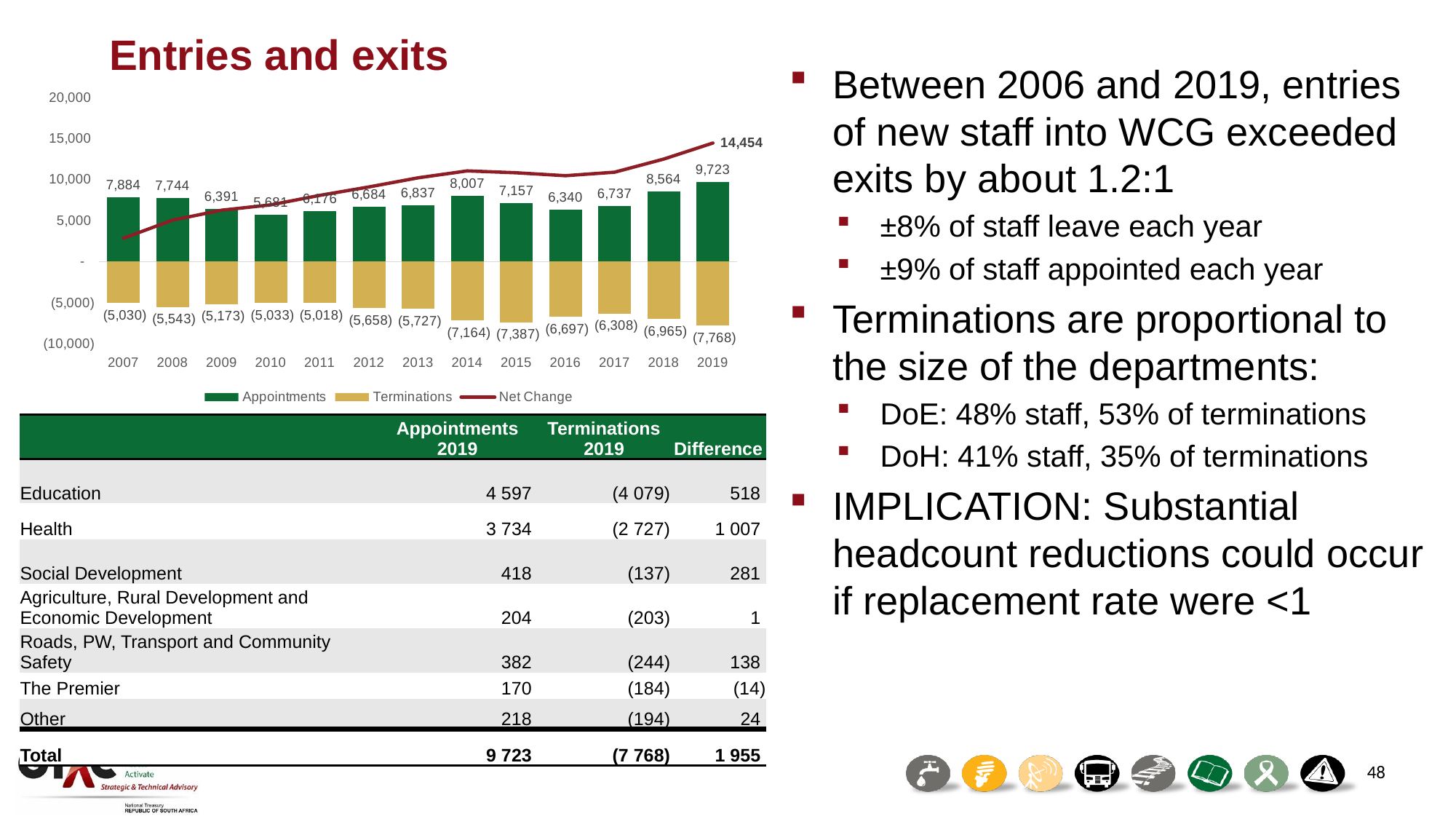
Is the Net Change value for 2007 greater or less than 5,000 in the Entries and exits chart? less Do Appointments rise or fall from 2016 to 2019 in the Entries and exits chart? rise What is the value of Terminations for 2015 in the Entries and exits chart? (7,387) How many years are shown on the x axis of the Entries and exits chart? 13 In which year are Appointments highest in the Entries and exits chart? 2019 What value is labelled on the Net Change line for 2019 in the Entries and exits chart? 14,454 What is the value of Appointments for 2019 in the Entries and exits chart? 9,723 In which year is the Terminations bar largest in magnitude in the Entries and exits chart? 2019 Which year has more Appointments in the Entries and exits chart, 2014 or 2015? 2014 By how much do Appointments in 2019 exceed Appointments in 2018 in the Entries and exits chart? 1,159 In which year are Appointments lowest in the Entries and exits chart? 2010 How many series does the legend of the Entries and exits chart list? 3